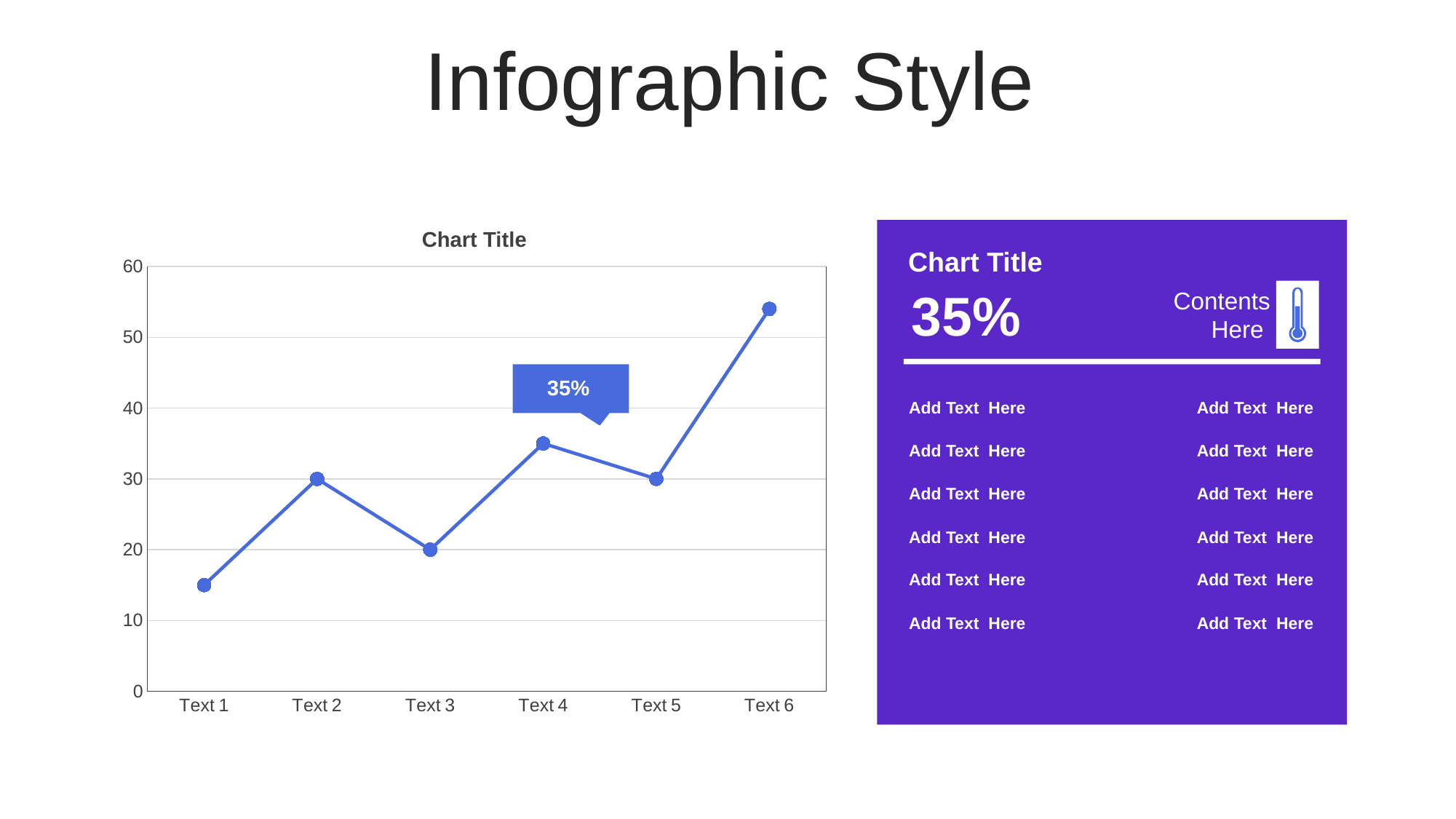
What is the difference between the values for Text 2 and Text 3? 10 What is the value for Text 2? 30 Which category has the highest value? Text 6 How many categories are plotted along the x axis of the chart? 6 Which has the larger value, Text 2 or Text 3? Text 2 Is the value for Text 1 greater or less than 20? less What type of chart is shown on the slide? line chart What is the title of the chart? Chart Title What is the value for Text 3? 20 Is the value for Text 6 greater or less than 50? greater What is the value for Text 5? 30 Which category has the lowest value? Text 1